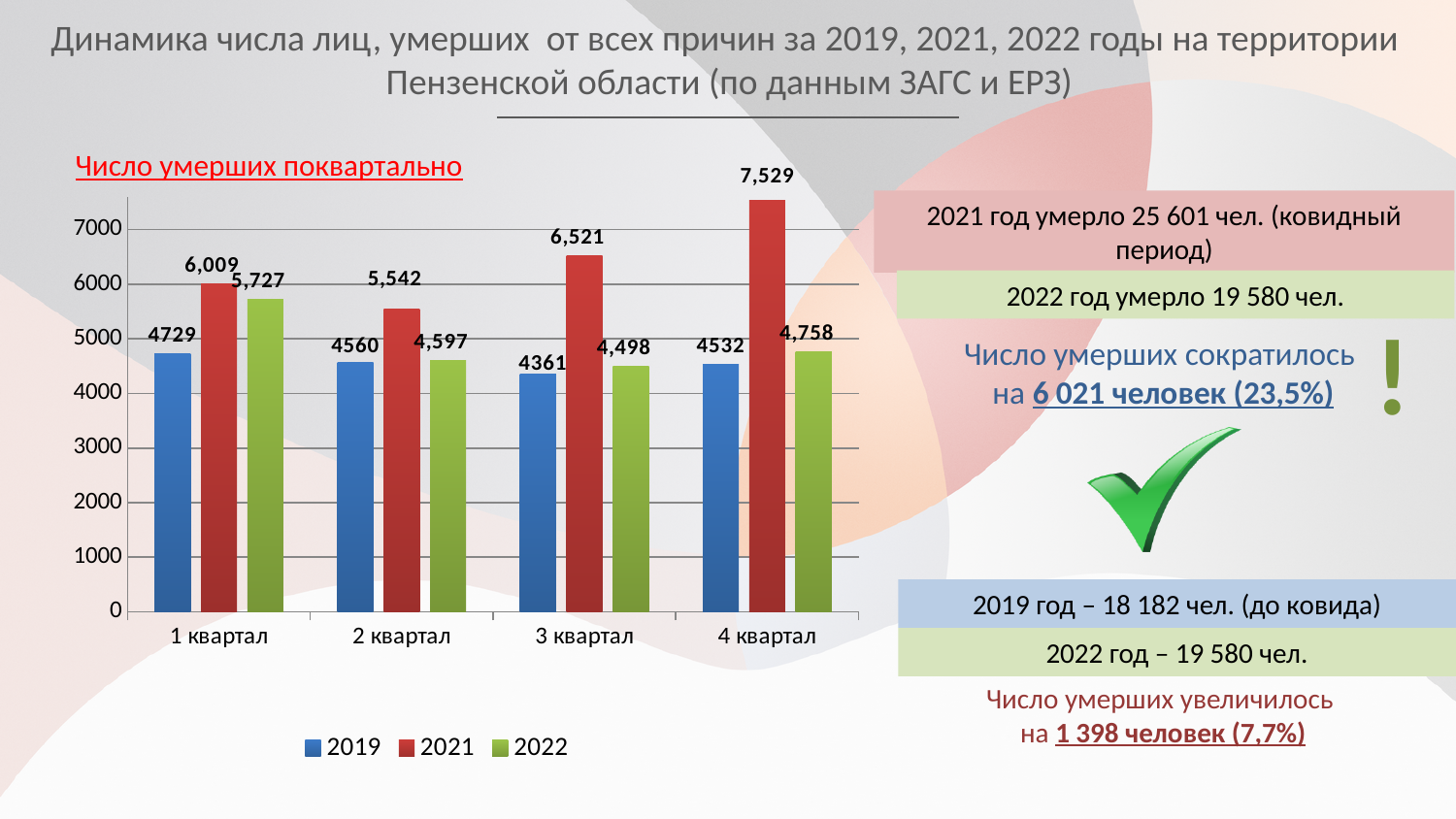
In which quarter is the 2021 value highest? 4 квартал What is the value for 2019 in 1 квартал? 4729 What is the difference between the 2021 and 2019 values in 4 квартал? 2997 What is the value for 2022 in 3 квартал? 4,498 In which quarter is the 2019 value lowest? 3 квартал How many series does the chart legend list? 3 What type of chart is shown on the slide? Bar chart What colour are the bars for the 2021 series? Red Which is larger in 3 квартал: the 2021 value or the 2022 value? 2021 What is the value for 2021 in 4 квартал? 7,529 Is the value for 2021 in 4 квартал greater or less than 7000? greater How many quarters (categories) are shown on the x axis of the chart? 4